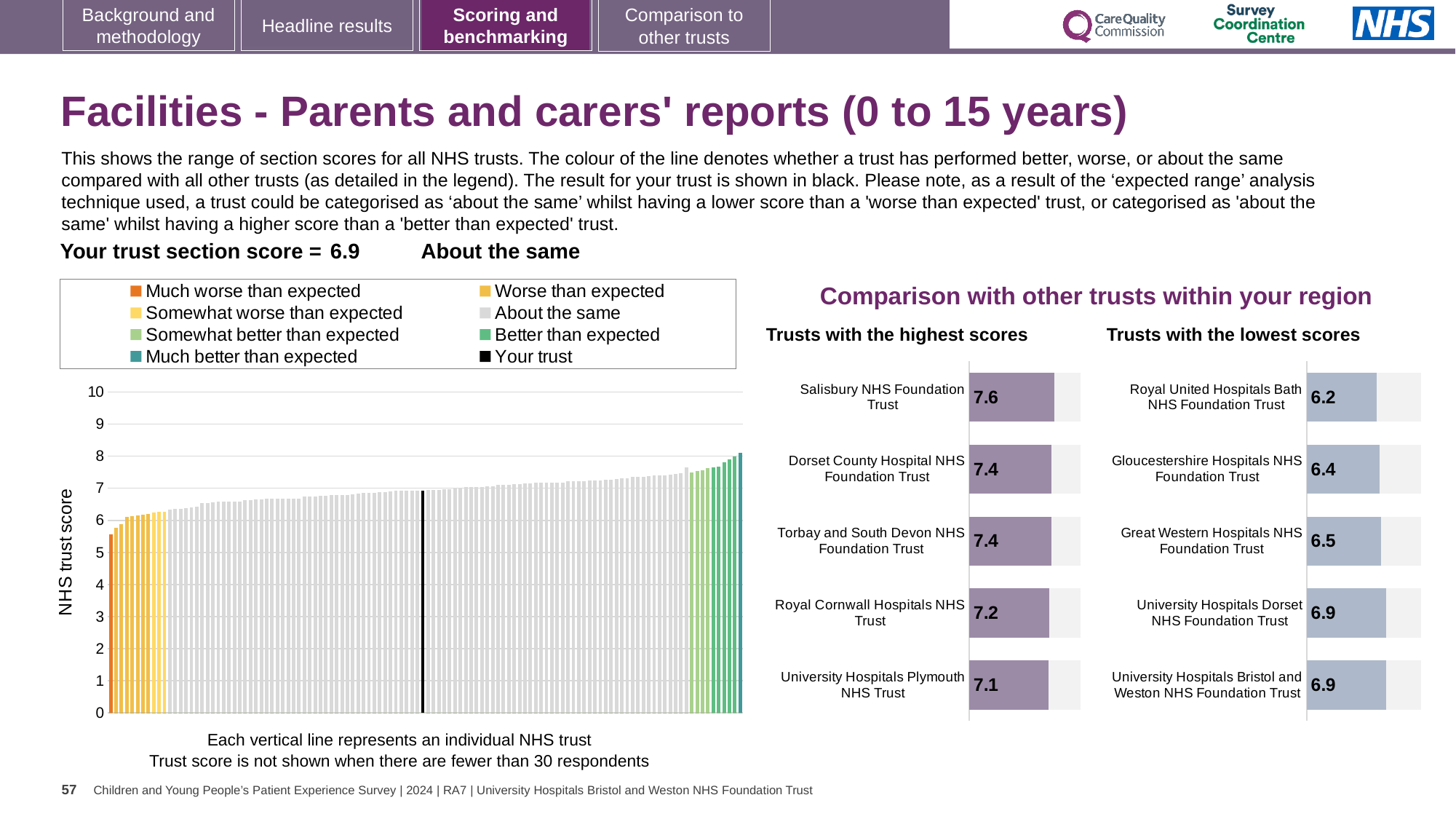
In the 'Trusts with the highest scores' chart, what is the difference between the scores of Salisbury NHS Foundation Trust and Royal Cornwall Hospitals NHS Trust? 0.4 In the 'Trusts with the highest scores' chart, which trust has the highest score? Salisbury NHS Foundation Trust In the 'Trusts with the highest scores' chart, what is the score for University Hospitals Plymouth NHS Trust? 7.1 In the main chart of all NHS trusts, is the value of the lowest (leftmost) bar greater or less than 6? less In the 'Trusts with the lowest scores' chart, what is the score for Royal United Hospitals Bath NHS Foundation Trust? 6.2 In the 'Trusts with the lowest scores' chart, what is the score for Great Western Hospitals NHS Foundation Trust? 6.5 In the 'Trusts with the lowest scores' chart, which has the larger score: Gloucestershire Hospitals NHS Foundation Trust or University Hospitals Dorset NHS Foundation Trust? University Hospitals Dorset NHS Foundation Trust What is the label on the vertical axis of the main chart of all NHS trusts? NHS trust score How many trusts are listed in the 'Trusts with the lowest scores' chart? 5 How many entries does the legend of the main NHS trust score chart list? 8 In the 'Trusts with the highest scores' chart, what is the score for Salisbury NHS Foundation Trust? 7.6 In the 'Trusts with the lowest scores' chart, which trust has the lowest score? Royal United Hospitals Bath NHS Foundation Trust